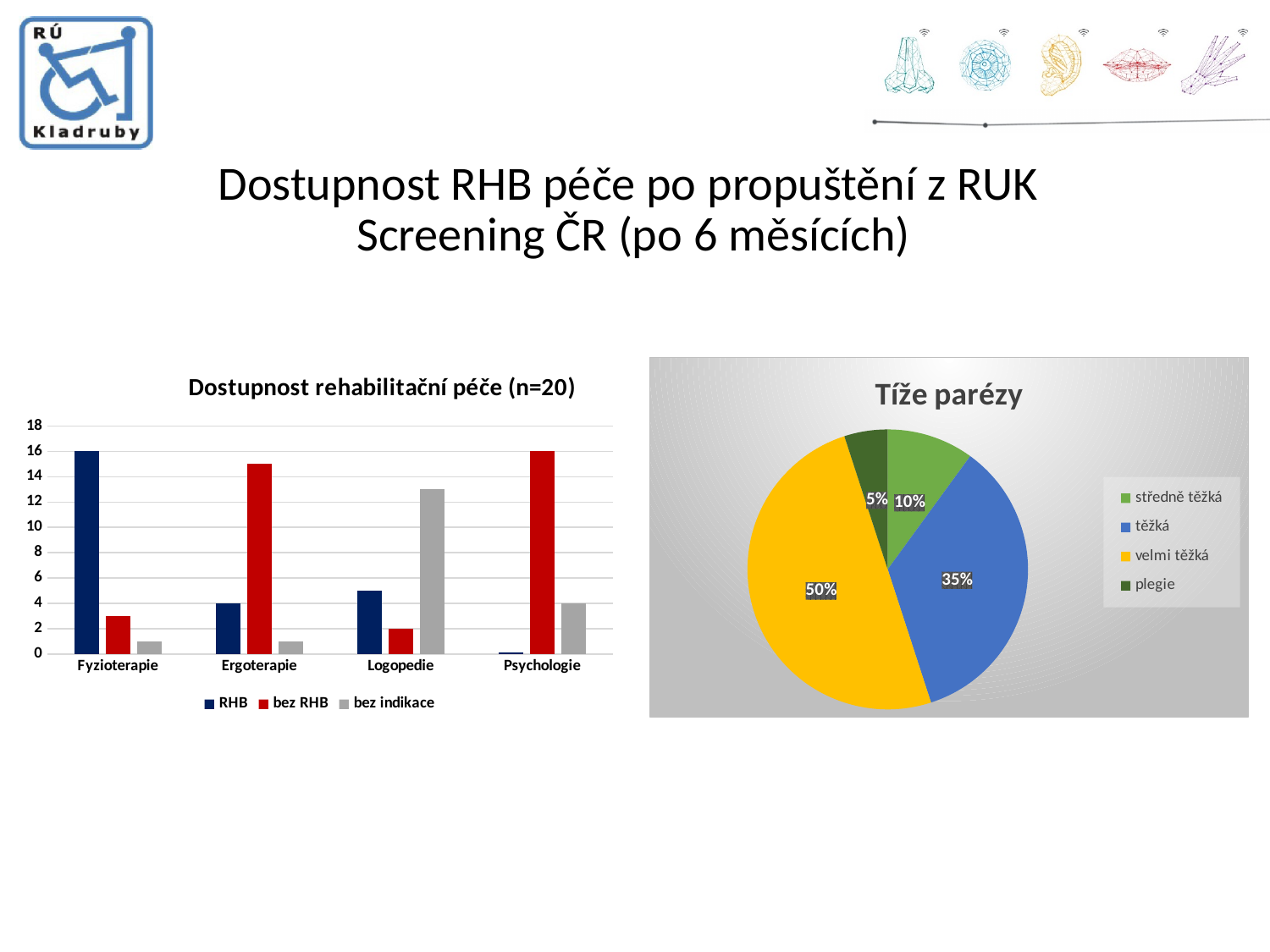
In the bar chart 'Dostupnost rehabilitační péče (n=20)', which category has the highest bez indikace value? Logopedie In the pie chart 'Tíže parézy', how many categories are shown? 4 In the bar chart 'Dostupnost rehabilitační péče (n=20)', is the value of bez indikace for Logopedie greater or less than 12? greater In the bar chart 'Dostupnost rehabilitační péče (n=20)', what is the value of bez RHB for Logopedie? 2 In the bar chart 'Dostupnost rehabilitační péče (n=20)', is the RHB value for Fyzioterapie larger or smaller than the RHB value for Logopedie? larger In the bar chart 'Dostupnost rehabilitační péče (n=20)', is the value of bez RHB for Ergoterapie greater or less than 14? greater In the bar chart 'Dostupnost rehabilitační péče (n=20)', what is the value of bez RHB for Psychologie? 16 In the bar chart 'Dostupnost rehabilitační péče (n=20)', what is the value of RHB for Ergoterapie? 4 In the bar chart 'Dostupnost rehabilitační péče (n=20)', how many series does the legend list? 3 In the pie chart 'Tíže parézy', what share does velmi těžká have? 50% In the pie chart 'Tíže parézy', which category has the smallest share? plegie In the bar chart 'Dostupnost rehabilitační péče (n=20)', what is the value of RHB for Fyzioterapie? 16